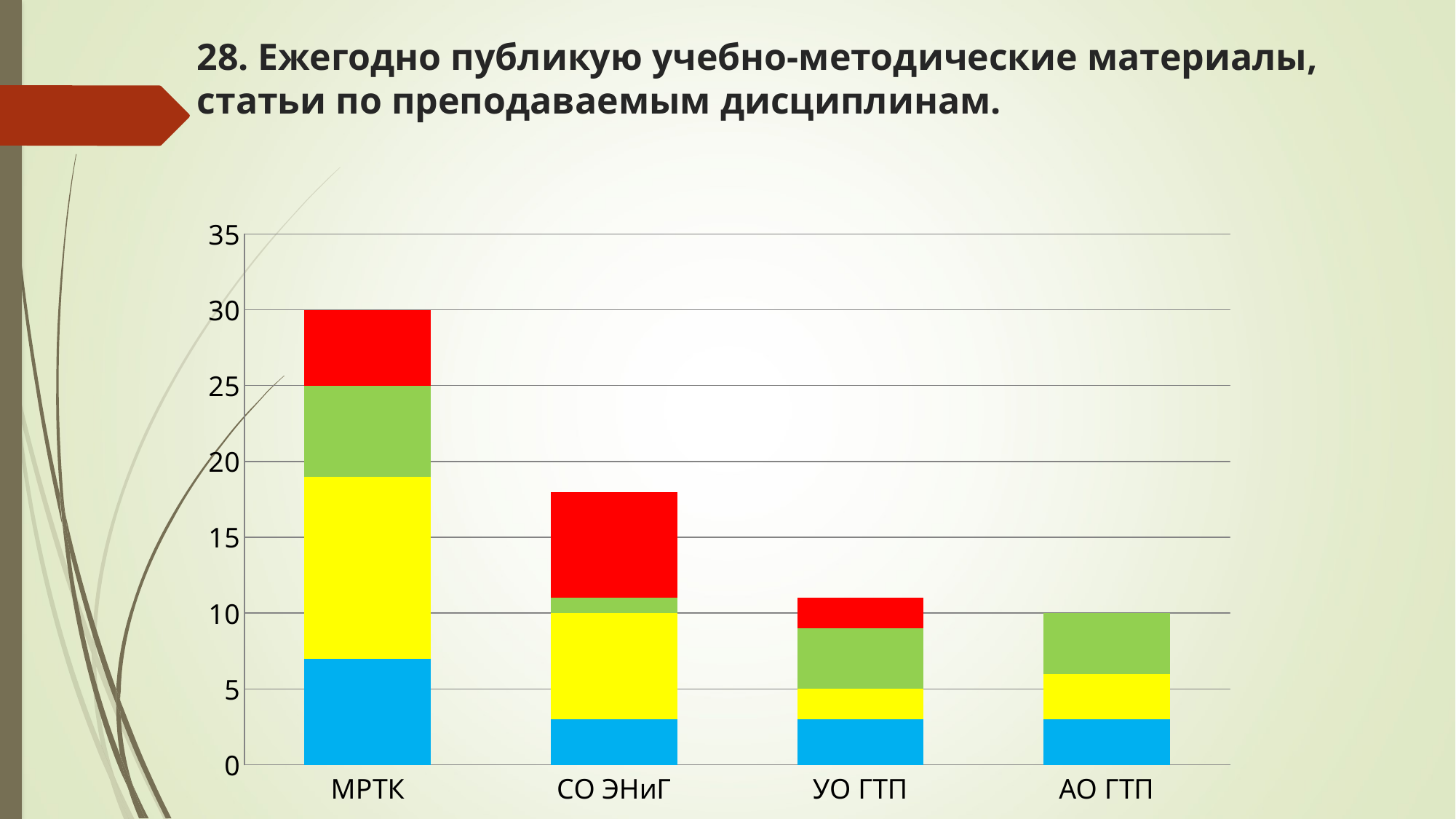
Which category has the shortest stacked bar? АО ГТП Which category's bar has no red segment? АО ГТП Which category has the tallest stacked bar? МРТК Is the total value for СО ЭНиГ greater or less than 20? less Is the total value for УО ГТП greater or less than 15? less What kind of chart is shown on the slide? bar chart What is the difference between the total for МРТК and the total for АО ГТП? 20 Which has a larger total, СО ЭНиГ or УО ГТП? СО ЭНиГ What is the total height of the stacked bar for АО ГТП? 10 How many categories are shown on the x axis? 4 Do the total bar heights rise or fall from left to right along the x axis? fall What is the total height of the stacked bar for МРТК? 30